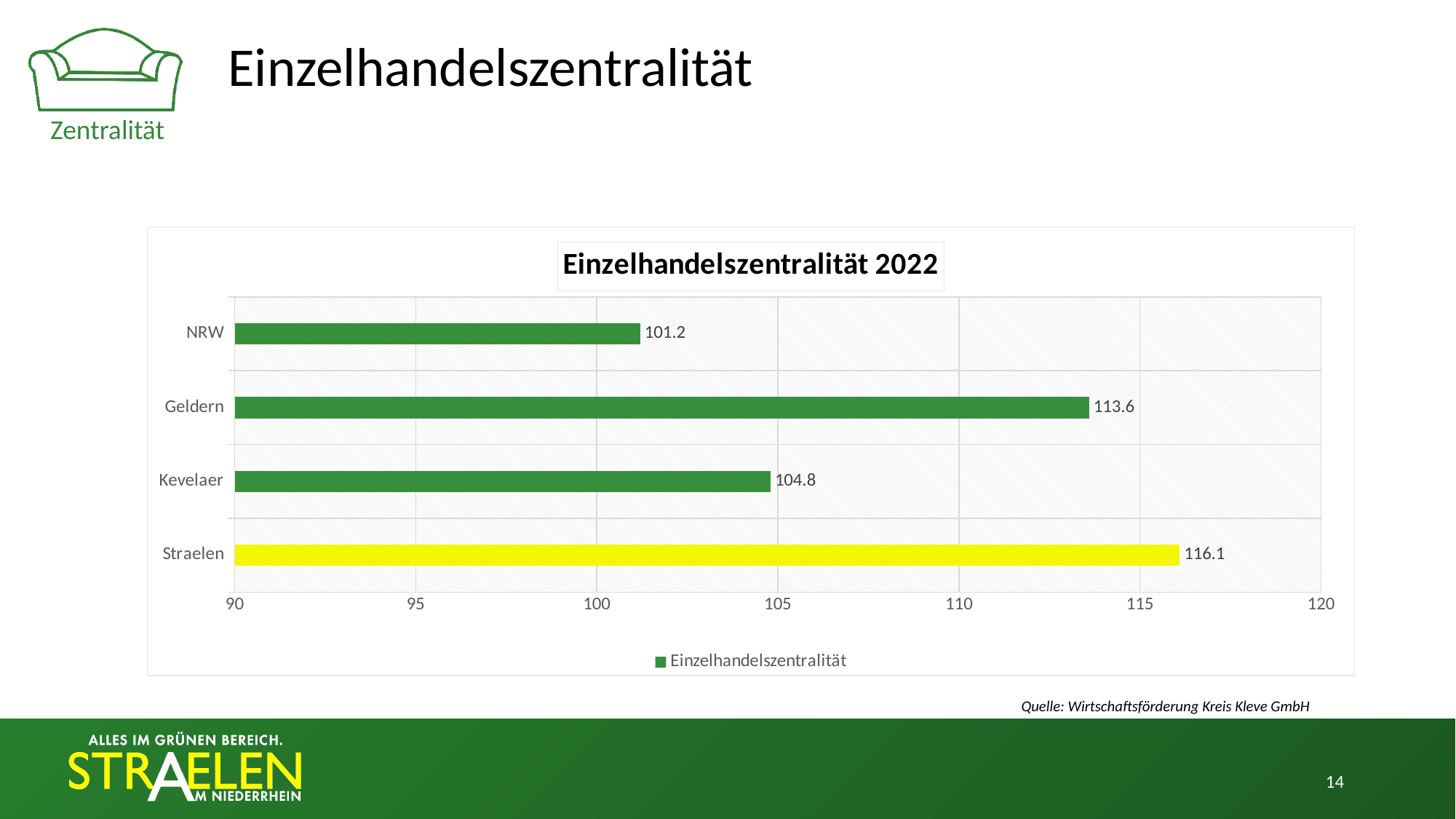
Which category has the highest Einzelhandelszentralität? Straelen Which category has the lowest Einzelhandelszentralität? NRW How many categories are shown in the chart? 4 What type of chart is shown on the slide? Bar chart What is the difference between the values for Straelen and NRW? 14.9 What is the difference between the values for Geldern and Kevelaer? 8.8 What is the Einzelhandelszentralität value for Straelen? 116.1 What is the Einzelhandelszentralität value for Kevelaer? 104.8 Which has a higher Einzelhandelszentralität, Kevelaer or Geldern? Geldern What is the Einzelhandelszentralität value for NRW? 101.2 What is the Einzelhandelszentralität value for Geldern? 113.6 What is the title of the chart? Einzelhandelszentralität 2022